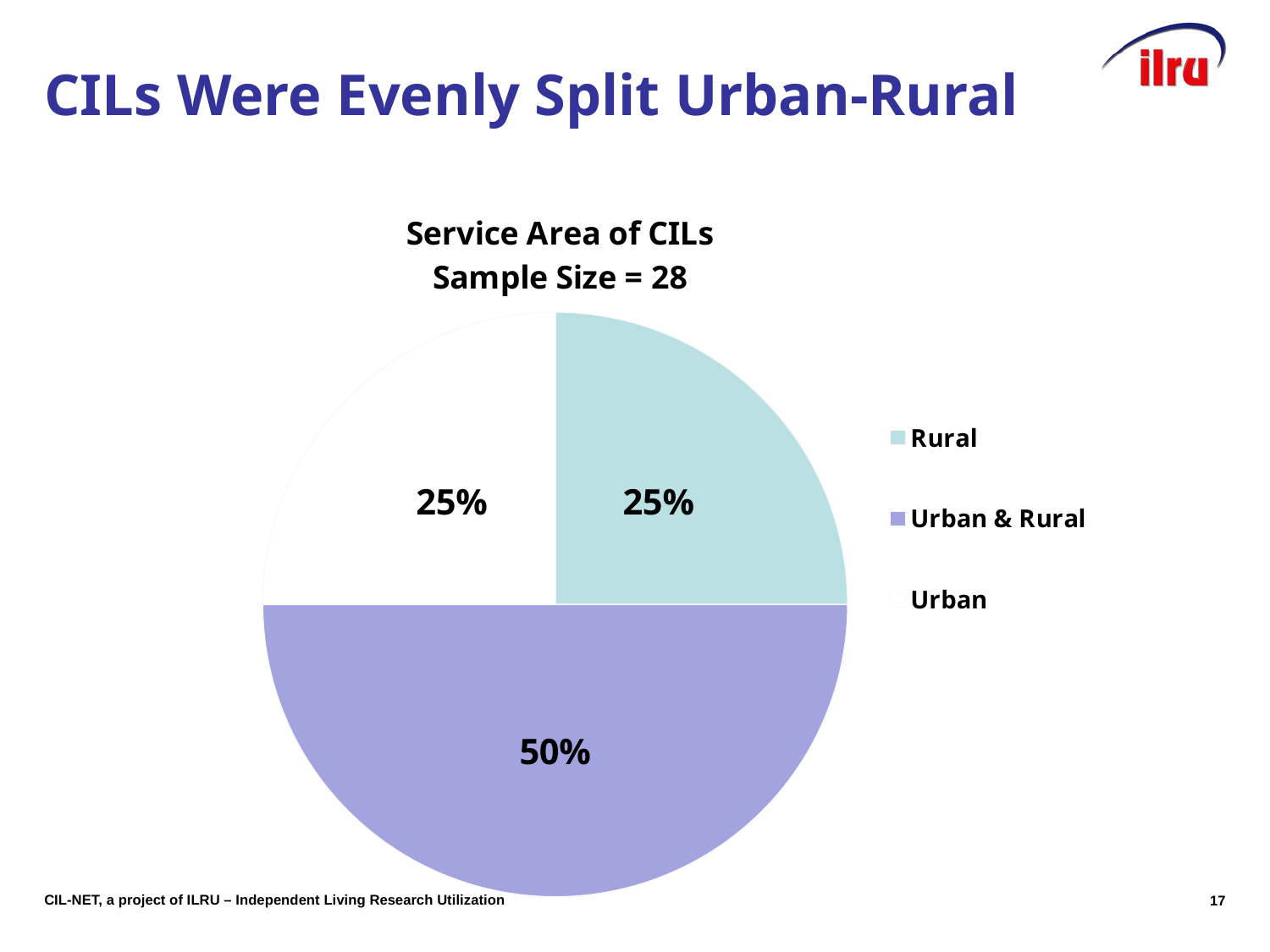
What is the title of the chart? Service Area of CILs Sample Size = 28 What share of the pie is Urban & Rural? 50% How many categories does the legend list? 3 What kind of chart is shown on the slide? Pie chart What is the sample size stated in the chart title? 28 Which category has the largest slice of the pie? Urban & Rural Is the share for Urban & Rural greater or less than 40%? greater Which is larger, the Urban & Rural slice or the Urban slice? Urban & Rural What share of the pie is Urban? 25% What share of the pie is Rural? 25% What is the combined share of the Rural and Urban slices? 50% What is the difference between the Urban & Rural share and the Rural share? 25%